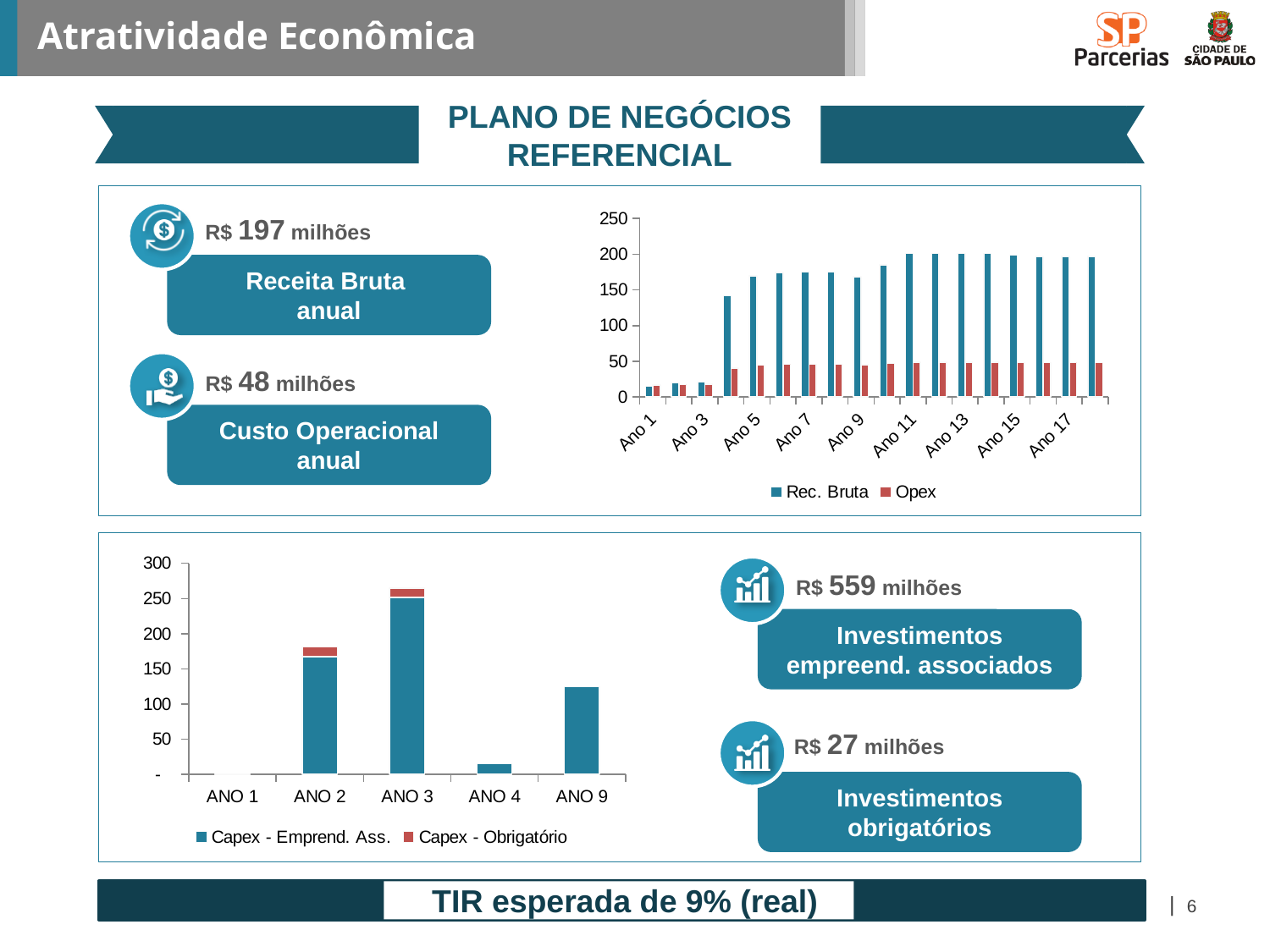
In the bottom-left chart, is the Capex - Emprend. Ass. value for ANO 2 greater or less than 150? greater In the top-right chart, does Rec. Bruta rise or fall from Ano 1 to Ano 11? rise In the bottom-left chart, what are the two series listed in the legend? Capex - Emprend. Ass. and Capex - Obrigatório In the top-right chart, is the Opex value for Ano 17 greater or less than 100? less In the top-right chart, is the Rec. Bruta value for Ano 1 greater or less than 50? less In the bottom-left chart, how many categories are shown on the x axis? 5 In the bottom-left chart, which category has the highest total bar? ANO 3 In the top-right chart, which series has the larger value in Ano 9, Rec. Bruta or Opex? Rec. Bruta What type of chart is the chart at the top right of the slide? bar chart In the top-right chart, how many series does the legend list? 2